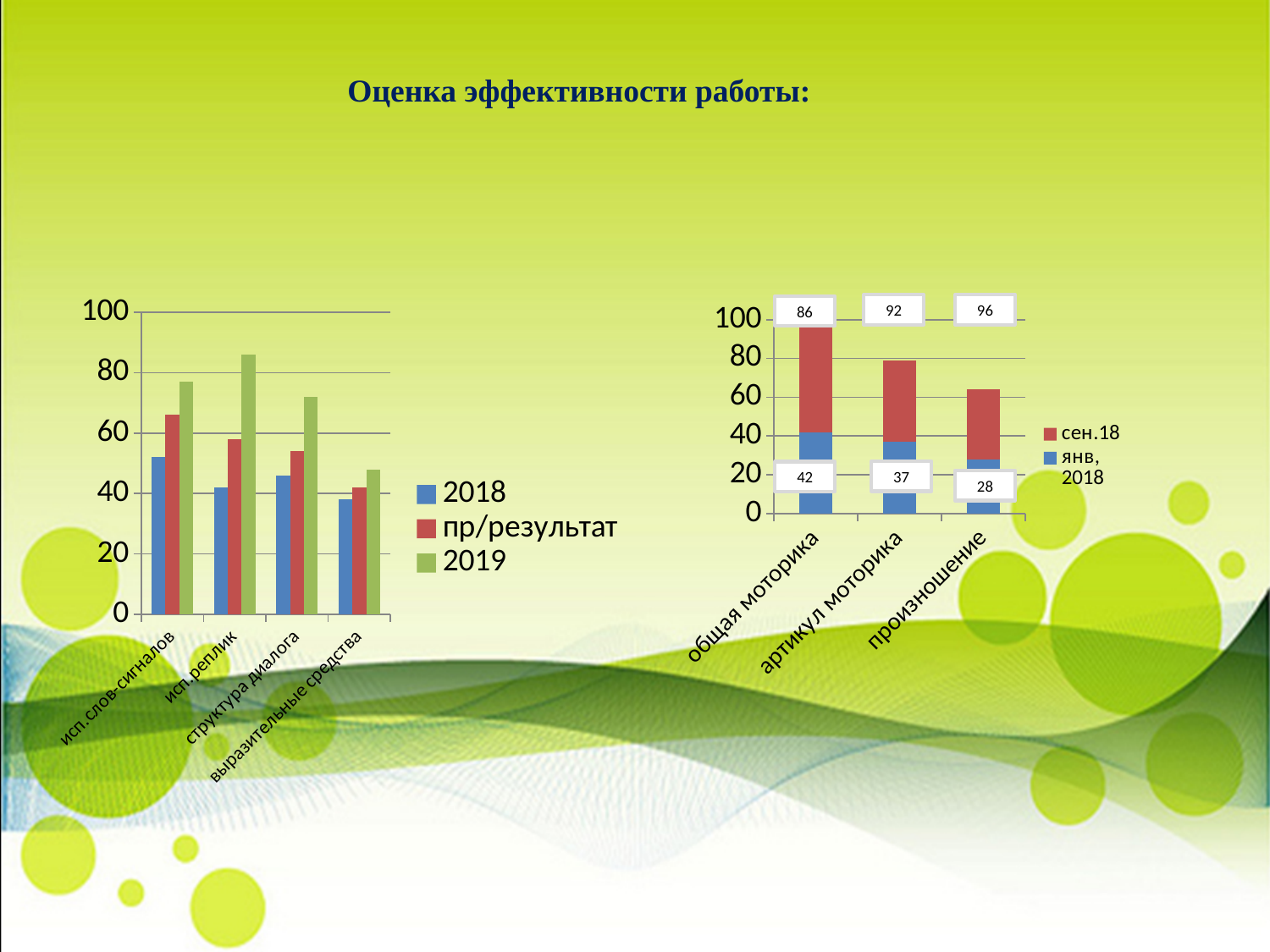
In the left chart, is the 2019 value for исп.реплик greater or less than 80? greater What kind of chart is the left chart? bar chart In the right chart, how many series does the legend list? 2 In the right chart, how many categories are shown on the x axis? 3 In the right chart, what is the difference between the янв, 2018 values for общая моторика and произношение? 14 In the left chart, is the 2018 value for выразительные средства greater or less than 40? less In the left chart, which category has the highest 2019 value? исп.реплик In the left chart, for структура диалога, which is larger: the 2018 value or the 2019 value? 2019 In the right chart, which category has the lowest янв, 2018 value? произношение In the right chart, what is the янв, 2018 value for артикул моторика? 37